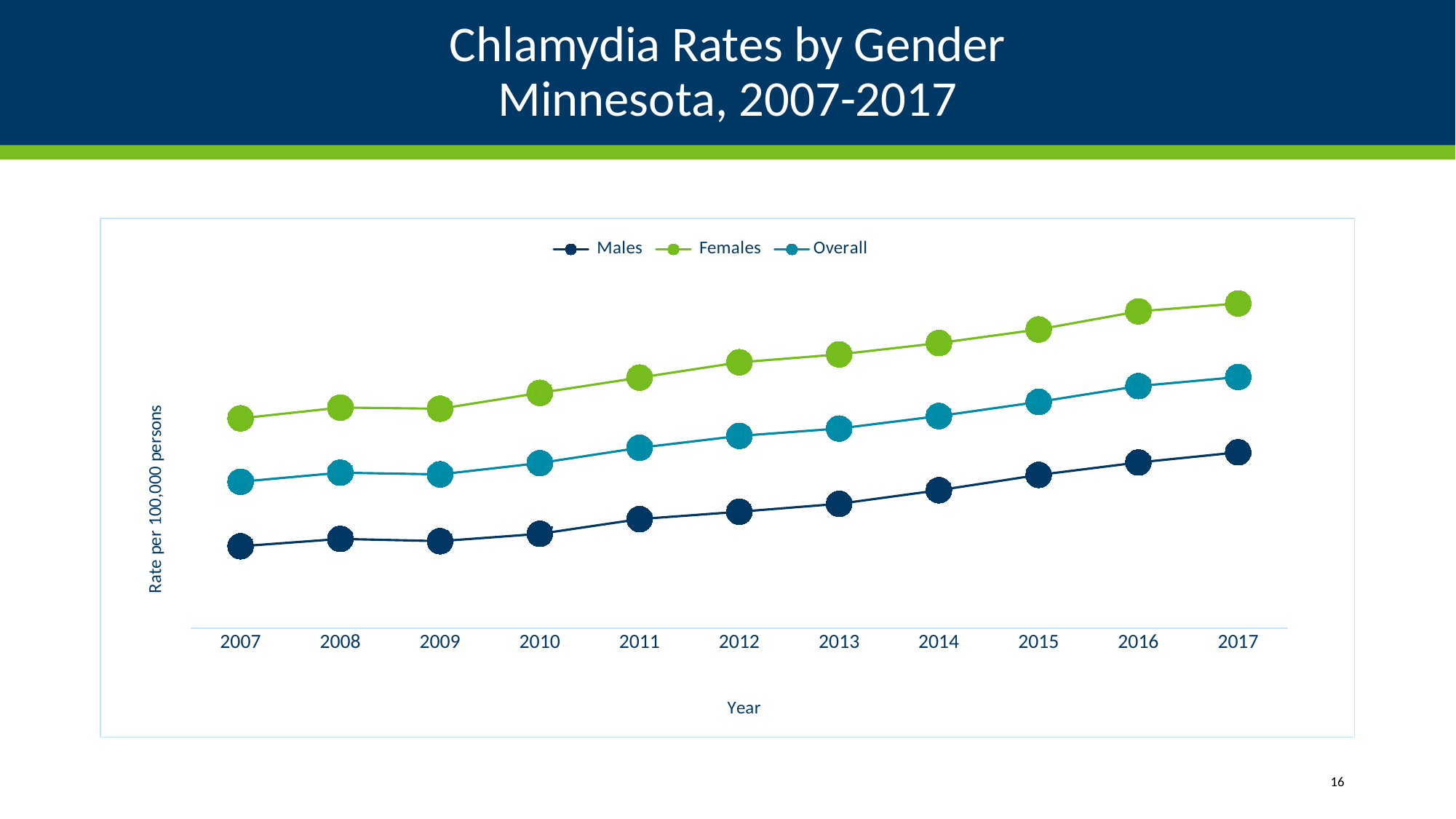
Which series has the highest rate in every year shown? Females Do the Overall rates generally rise or fall from 2007 to 2017? Rise What kind of chart is shown on the slide? Line chart Which series is drawn in green? Females In which year is the Females rate highest? 2017 What is the label on the y axis? Rate per 100,000 persons Which series has the lowest rate in every year shown? Males How many years are plotted along the x axis? 11 In which year is the Males rate lowest? 2007 How many series does the legend list? 3 Which is larger in 2010, the rate for Overall or the rate for Males? Overall Which is larger in 2017, the rate for Females or the rate for Males? Females